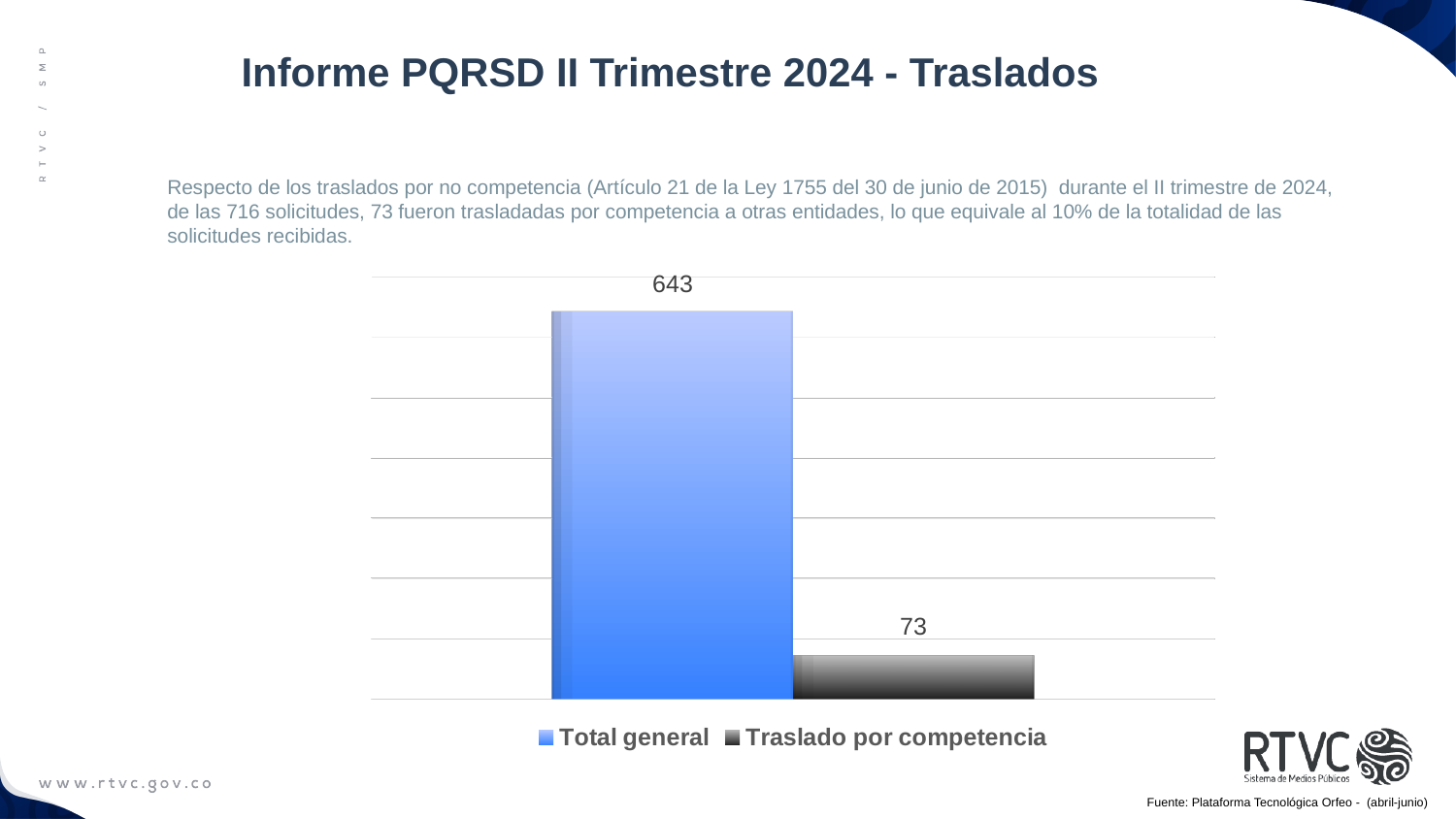
How many bars are plotted in the chart? 2 Which series has the lowest value? Traslado por competencia What colour is the bar for Traslado por competencia? grey What is the difference between Total general and Traslado por competencia? 570 Which is larger, Total general or Traslado por competencia? Total general What kind of chart is shown on the slide? bar chart Which series has the highest value? Total general How many series does the legend list? 2 What colour is the bar for Total general? blue What is the value for Traslado por competencia? 73 What is the value for Total general? 643